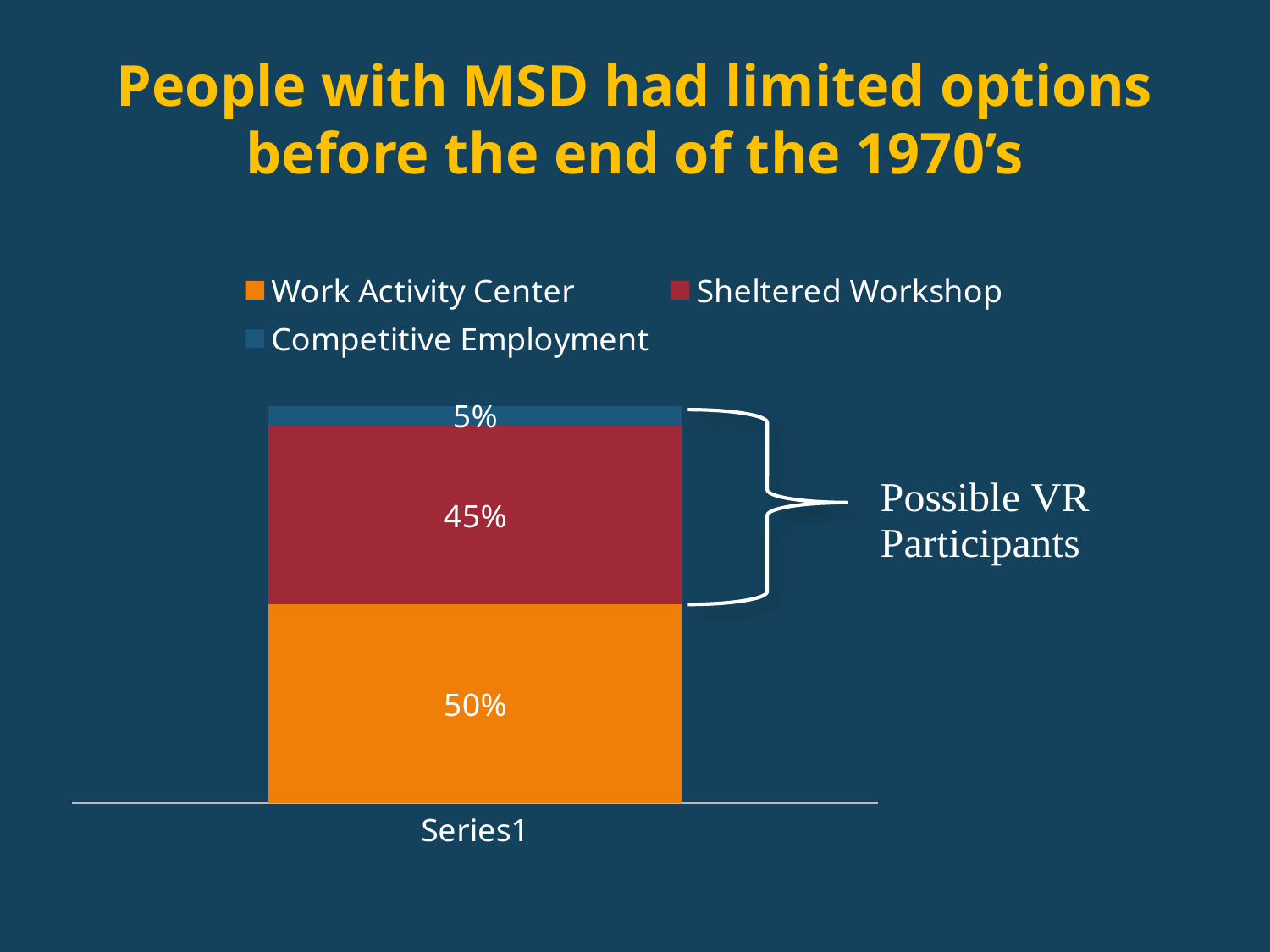
What percentage is shown for Work Activity Center? 50% How many series does the legend list? 3 What percentage is shown for Competitive Employment? 5% Which series has the largest share of the stacked bar? Work Activity Center What is the total of the stacked bar? 100% Which is larger, Sheltered Workshop or Competitive Employment? Sheltered Workshop What percentage is shown for Sheltered Workshop? 45% What is the difference between the Work Activity Center and Sheltered Workshop percentages? 5% What label is shown on the x axis under the bar? Series1 Which series has the smallest share of the stacked bar? Competitive Employment What is the difference between the Sheltered Workshop and Competitive Employment percentages? 40% What kind of chart is shown on the slide? Stacked bar chart